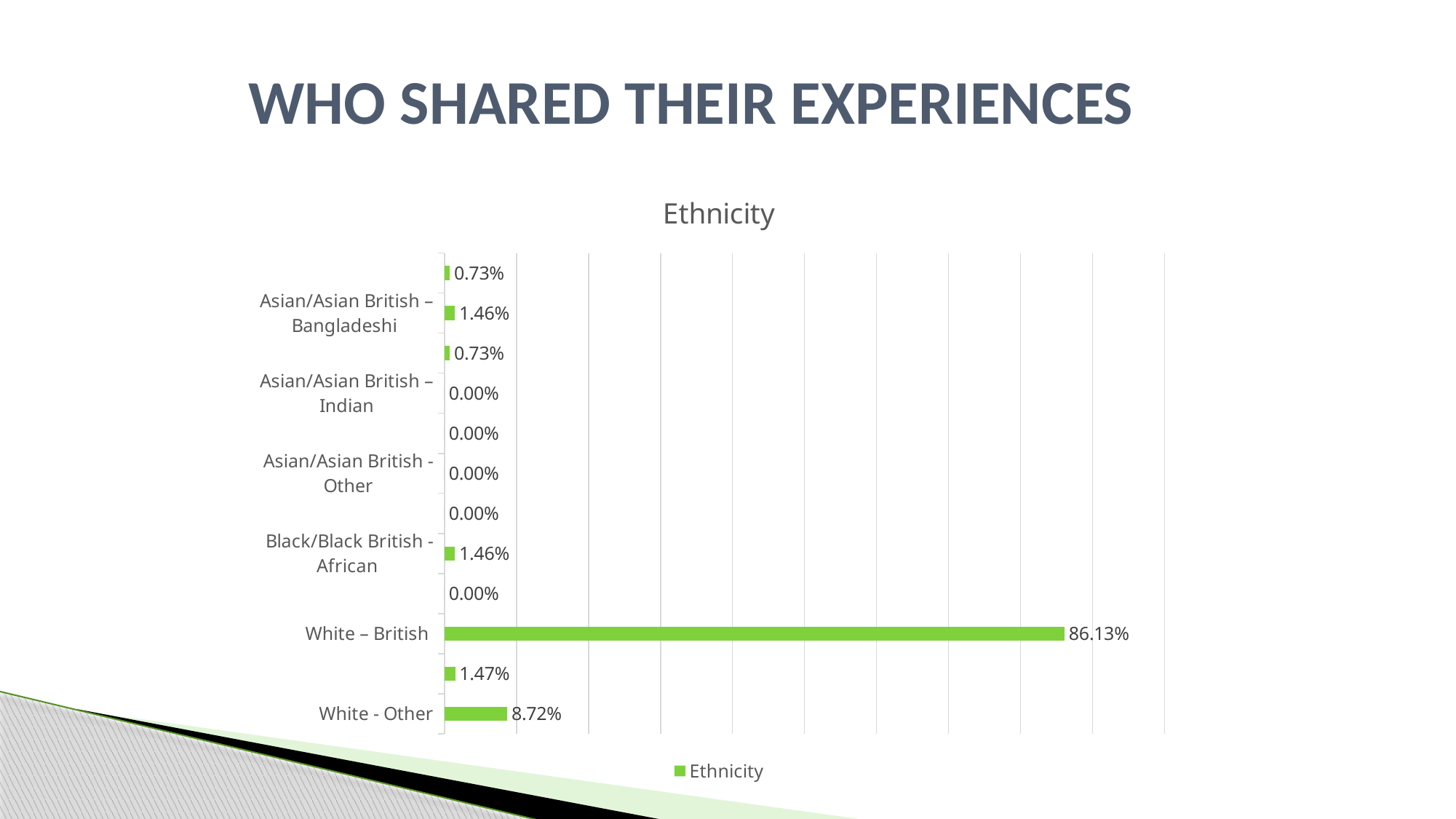
What is the value for White – British? 86.13% What is the value for Black/Black British - African? 1.46% Which is larger, the value for White - Other or the value for Black/Black British - African? White - Other What is the value for Asian/Asian British – Indian? 0.00% What is the title of the chart? Ethnicity Which category has the highest value? White – British What is the difference between the values for White – British and White - Other? 77.41% How many series does the legend list? 1 What is the value for Asian/Asian British - Other? 0.00% What is the value for White - Other? 8.72% What is the value for Asian/Asian British – Bangladeshi? 1.46% What kind of chart is shown on the slide? bar chart